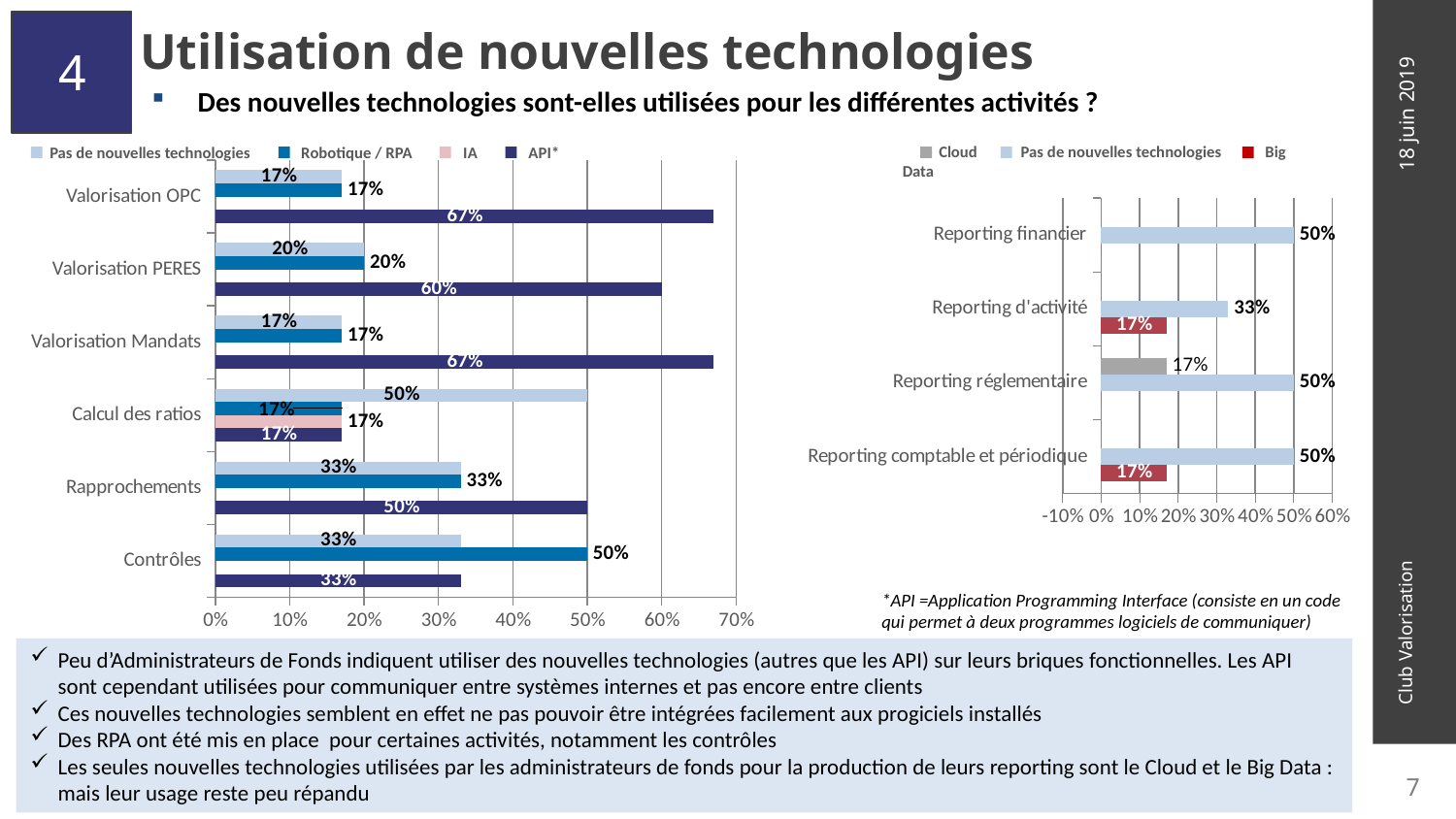
In the left chart, what is the 'Pas de nouvelles technologies' value for Calcul des ratios? 50% How many series does the legend of the left chart list? 4 In the left chart, which is larger for Contrôles: the Robotique / RPA value or the API* value? Robotique / RPA In the left chart, what is the difference between the API* value for Valorisation PERES and the API* value for Rapprochements? 10% In the right chart, what is the 'Pas de nouvelles technologies' value for Reporting d'activité? 33% In the left chart, what is the Robotique / RPA value for Contrôles? 50% How many categories are shown in the left chart? 6 In the left chart, which category has the lowest API* value? Calcul des ratios In the right chart, what is the Cloud value for Reporting réglementaire? 17% In the left chart, what is the API* value for Valorisation OPC? 67% What type of chart is the right chart? Bar chart How many categories are shown in the right chart? 4